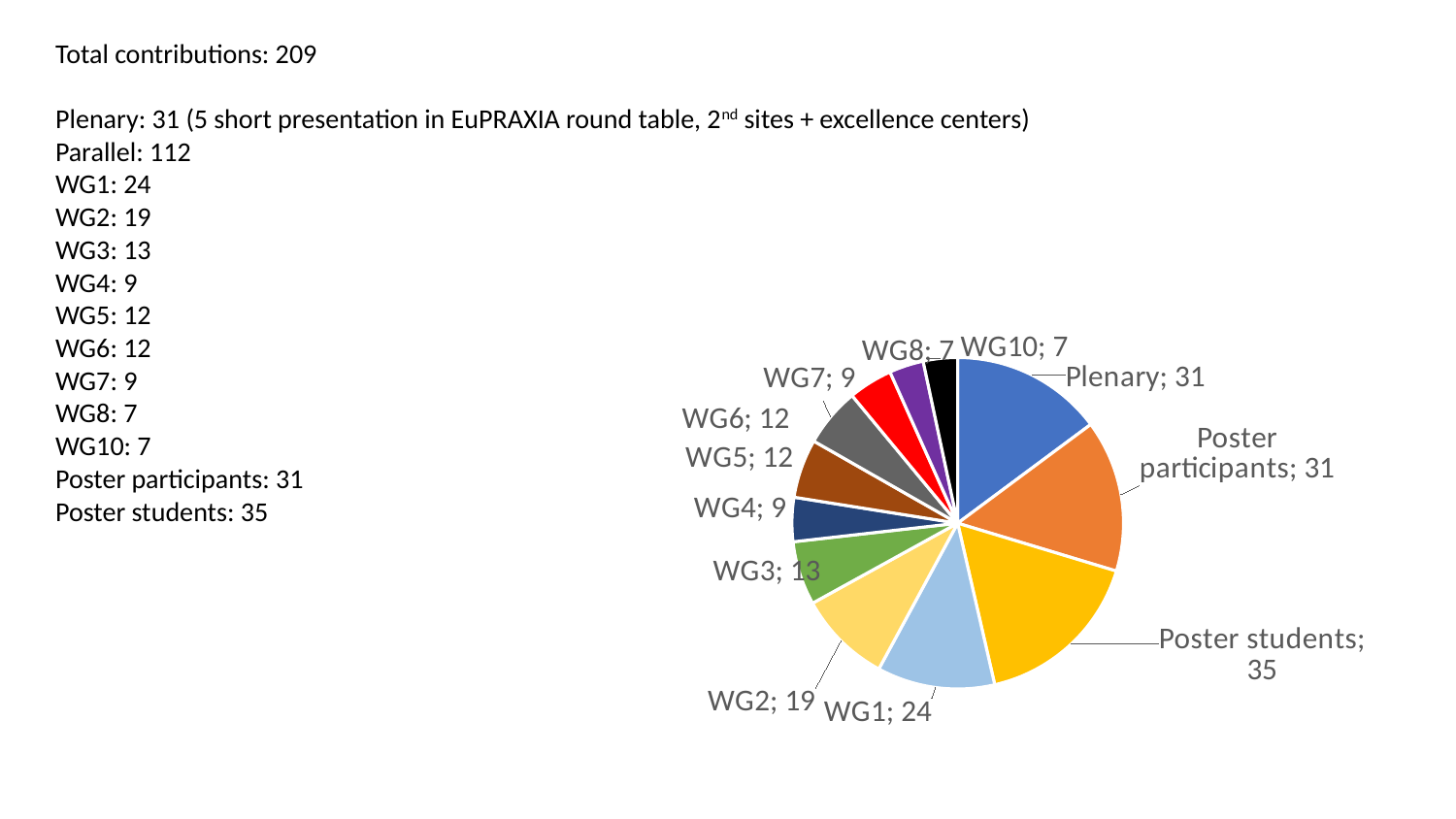
What kind of chart is shown on the slide? pie chart Which category has the largest slice in the pie chart? Poster students What is the total of all the slices in the pie chart? 209 Which is larger, the value for WG2 or the value for WG4? WG2 What is the value for WG3 in the pie chart? 13 How many slices does the pie chart have? 12 Which two categories share the smallest value in the pie chart? WG8 and WG10 What is the difference between the values for WG1 and WG2? 5 What is the value for WG1 in the pie chart? 24 What colour is the WG10 slice in the pie chart? black What is the difference between the values for Poster students and Plenary? 4 What is the value for Poster students in the pie chart? 35